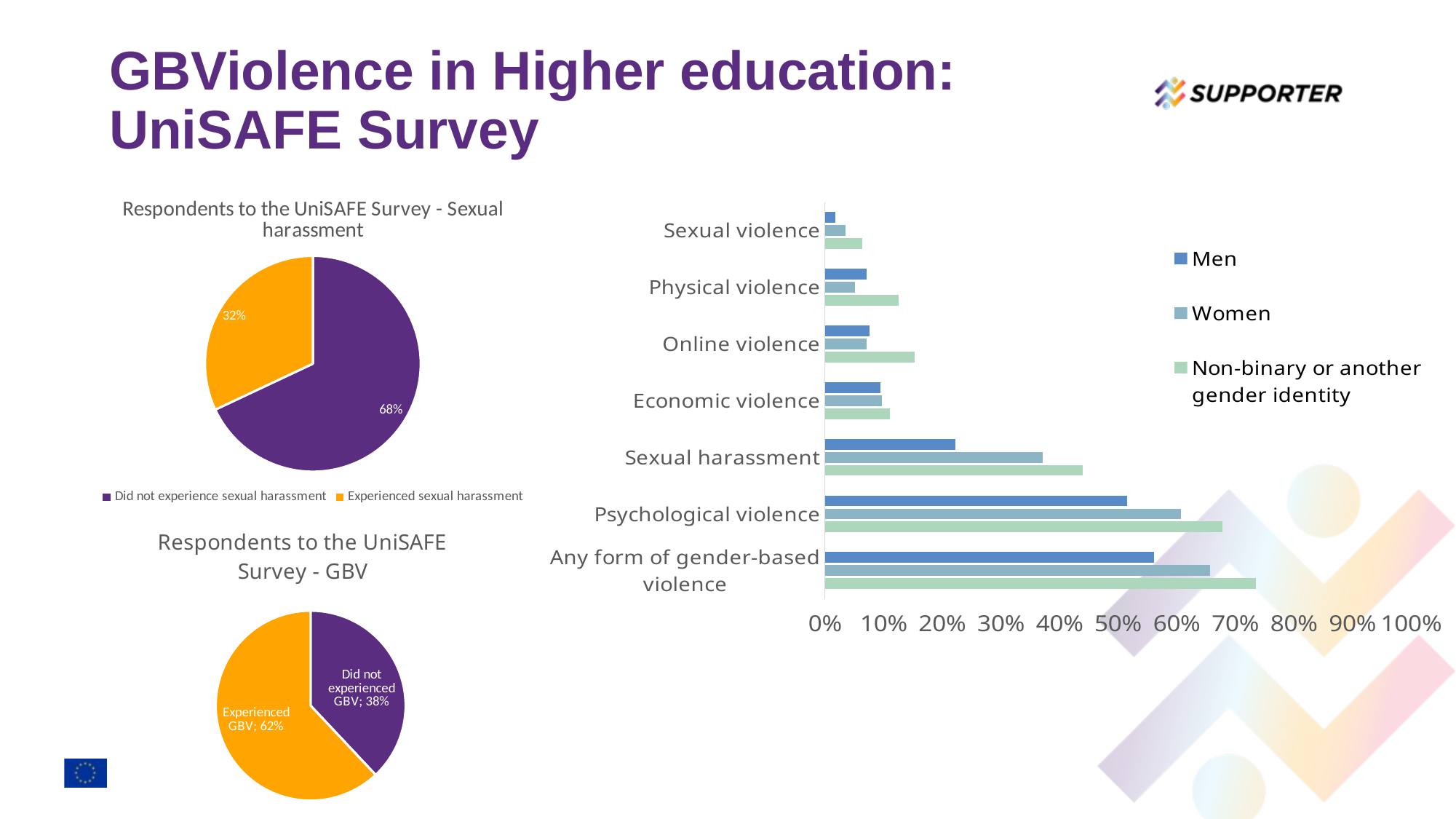
In the pie chart titled 'Respondents to the UniSAFE Survey - Sexual harassment', what share of respondents experienced sexual harassment? 32% In the pie chart titled 'Respondents to the UniSAFE Survey - GBV', what is the difference between the share that experienced GBV and the share that did not? 24% In the pie chart titled 'Respondents to the UniSAFE Survey - GBV', what share of respondents experienced GBV? 62% How many series does the legend of the bar chart on the right list? 3 In the pie chart titled 'Respondents to the UniSAFE Survey - Sexual harassment', what share of respondents did not experience sexual harassment? 68% What kind of chart is the chart on the right side of the slide? Bar chart In the bar chart on the right, is the value for 'Women' in 'Sexual harassment' greater or less than 30%? greater In the bar chart on the right, which category has the highest value for 'Non-binary or another gender identity'? Any form of gender-based violence In the pie chart titled 'Respondents to the UniSAFE Survey - Sexual harassment', which slice is larger: 'Did not experience sexual harassment' or 'Experienced sexual harassment'? Did not experience sexual harassment How many categories are shown on the bar chart on the right? 7 In the bar chart on the right, which category has the lowest value for 'Men'? Sexual violence In the bar chart on the right, is the value for 'Non-binary or another gender identity' in 'Any form of gender-based violence' greater or less than 70%? greater